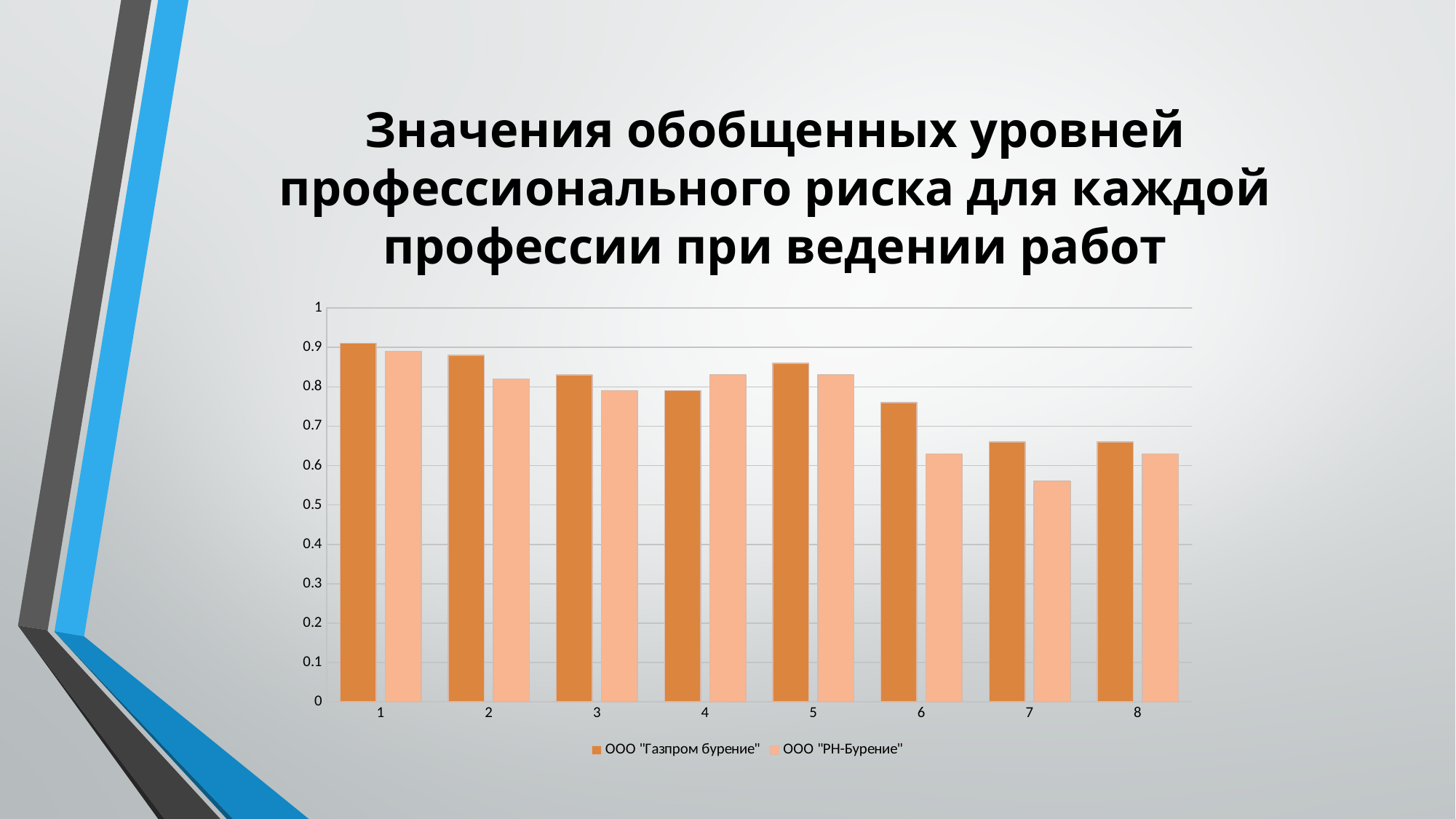
How many categories are shown along the x axis of the chart? 8 How many series does the chart's legend list? 2 Do the values for ООО "Газпром бурение" generally rise or fall from category 1 to category 8? fall What kind of chart is shown on the slide? bar chart Which series is shown in the darker orange colour in the chart? ООО "Газпром бурение" Is the value for ООО "Газпром бурение" at category 6 greater or less than 0.7? greater Is the value for ООО "Газпром бурение" at category 7 greater or less than 0.7? less Is the value for ООО "Газпром бурение" at category 5 greater or less than 0.8? greater For which category is the value for ООО "РН-Бурение" lowest? 7 For which category is the value for ООО "Газпром бурение" highest? 1 At category 4, which series has the larger value, ООО "Газпром бурение" or ООО "РН-Бурение"? ООО "РН-Бурение"